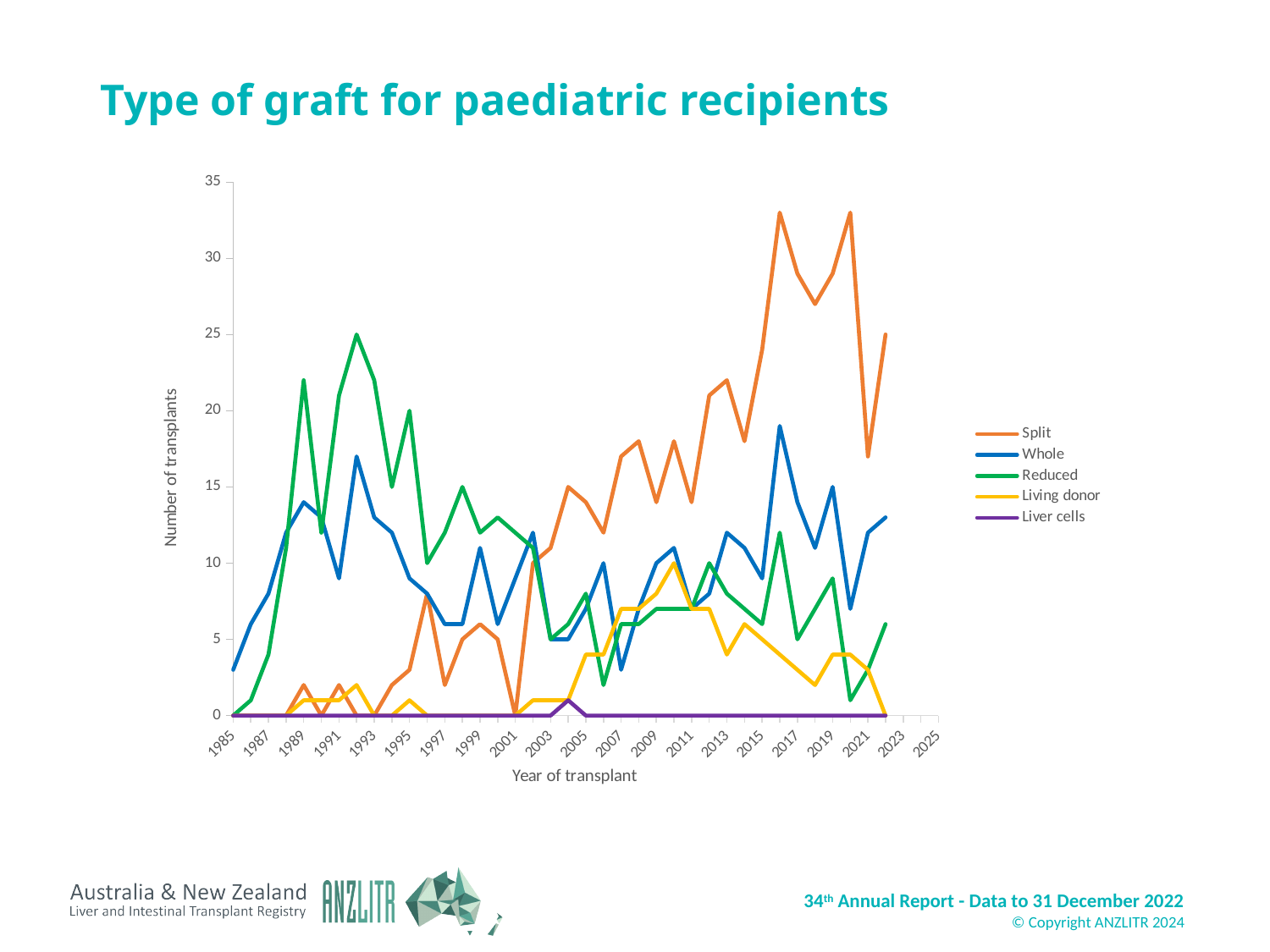
What is the title of the chart? Type of graft for paediatric recipients What is the label on the vertical axis? Number of transplants Is the value for Reduced in 1992 greater or less than 20? greater Is the value for Whole in 2016 greater or less than 15? greater Is the value for Split in 2016 greater or less than 30? greater What kind of chart is shown on the slide? Line chart Which series has the lowest values across the whole period? Liver cells In 1992, which is larger: the value for Reduced or the value for Split? Reduced What is the value for Liver cells in 2015? 0 Which series has the highest value in 2016? Split How many series does the legend list? 5